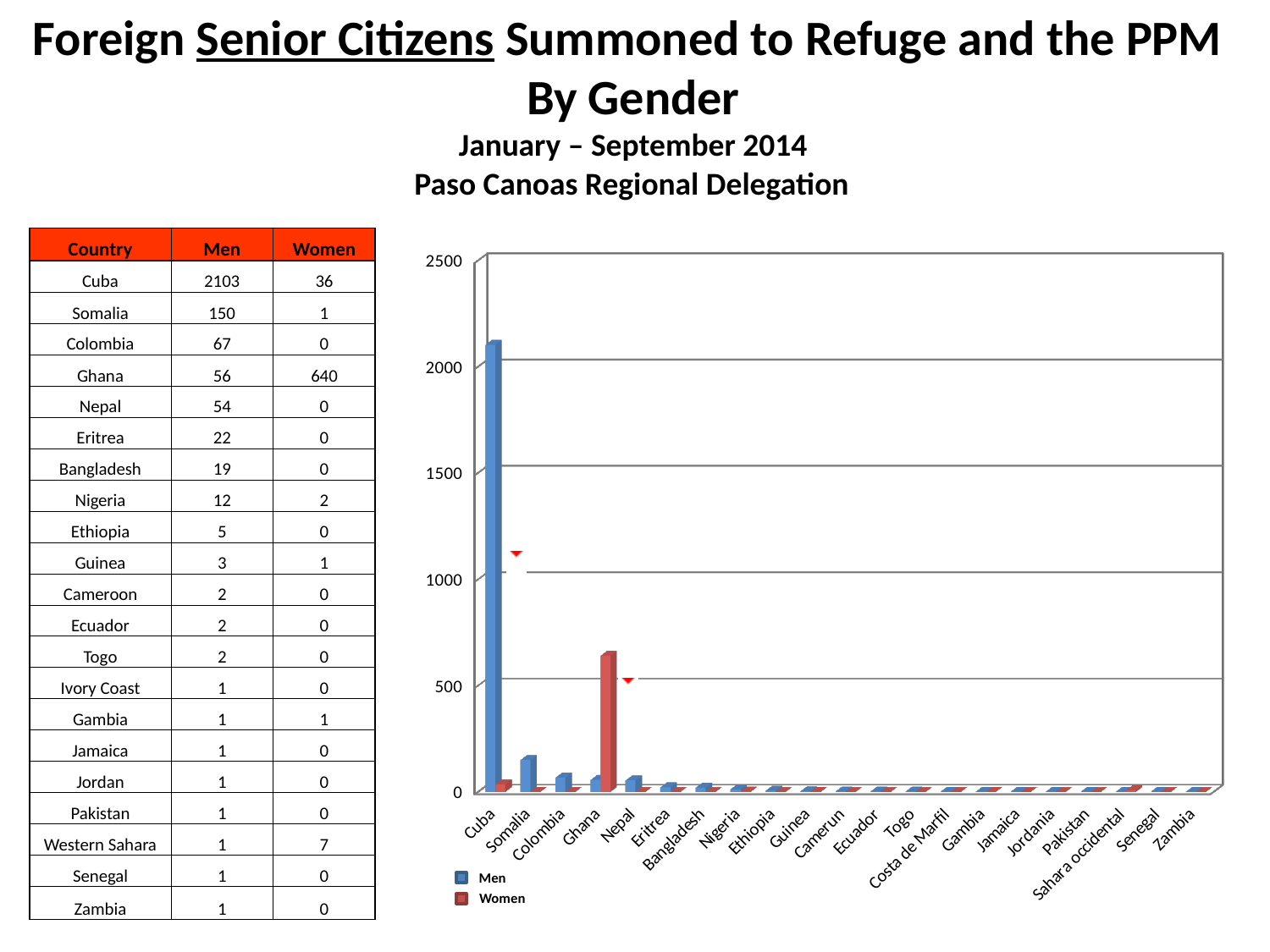
Which is larger, the Men value for Somalia or the Men value for Colombia? Somalia What is the value for Men for Cuba? 2103 Is the value for Men for Cuba greater or less than 2000? greater What is the value for Men for Somalia? 150 How many series does the chart legend list? 2 Which country has the highest value for Men? Cuba What is the difference between the Men value for Cuba and the Men value for Somalia? 1953 What kind of chart is shown on the slide? bar chart How many countries are shown along the x axis of the chart? 21 What are the two series named in the chart legend? Men and Women What is the value for Women for Ghana? 640 Which country has the highest value for Women? Ghana